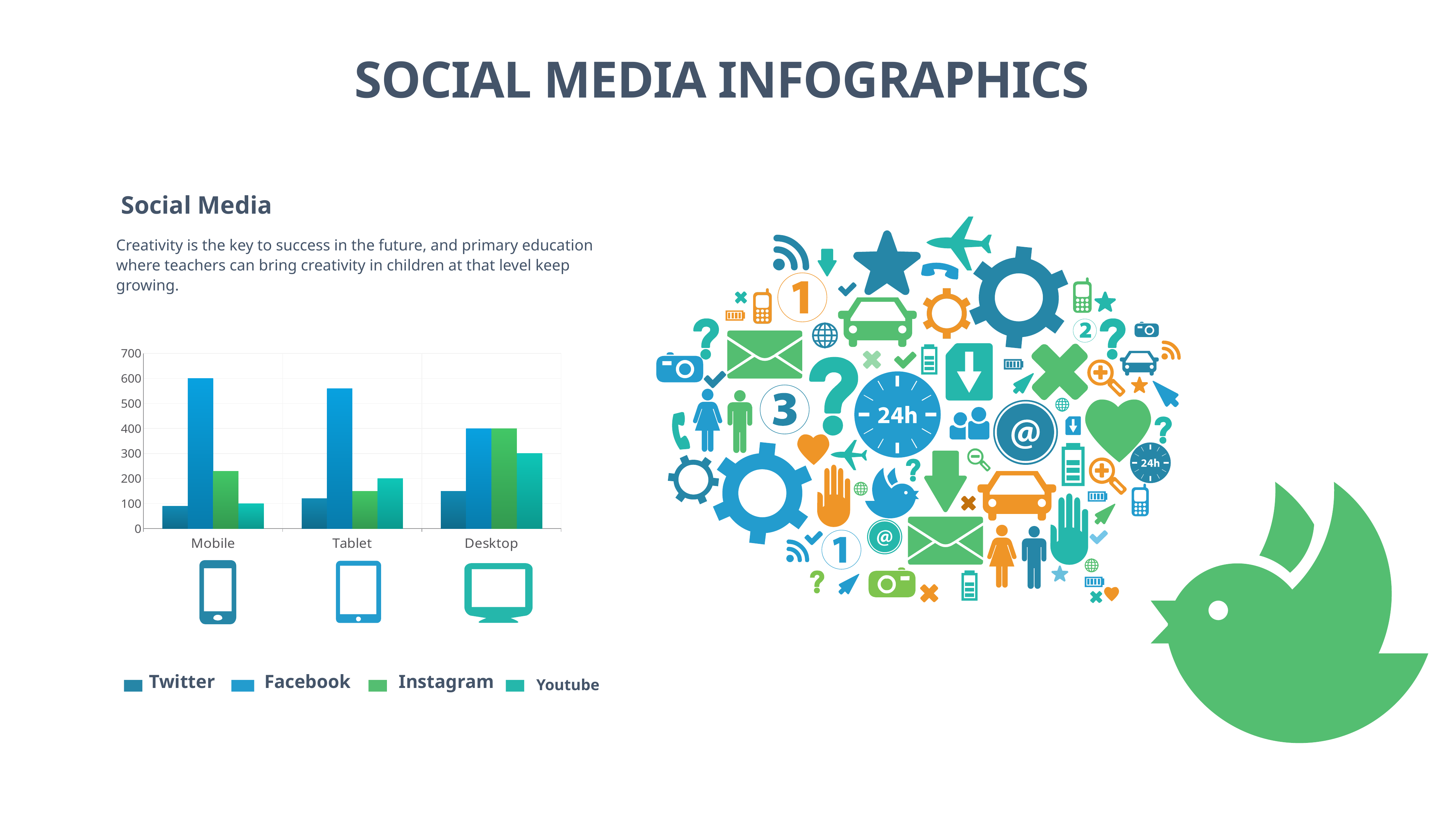
Is the value for Instagram in the Mobile category greater or less than 200? greater Which series has the highest value for Mobile? Facebook Which is larger: the Youtube value for Tablet or the Youtube value for Mobile? Tablet Which series has the highest value for Tablet? Facebook How many categories are shown on the x axis of the chart? 3 What kind of chart is shown on the slide? bar chart Which series has the lowest value for Desktop? Twitter How many series does the chart's legend list? 4 Is the value for Twitter in the Desktop category greater or less than 200? less What is the title of the chart? Social Media Is the value for Twitter in the Mobile category greater or less than 200? less